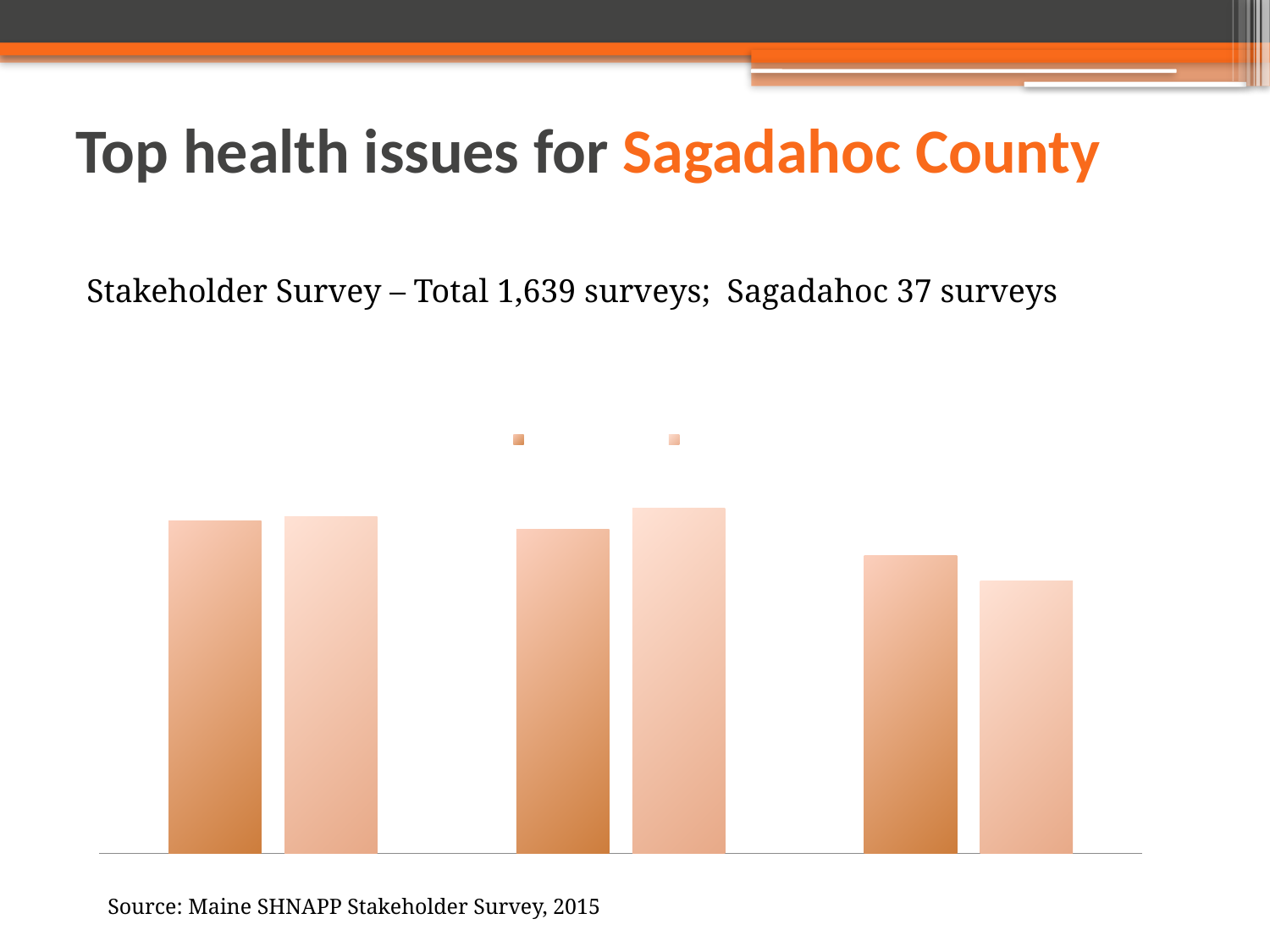
In the middle group of bars, is the darker bar or the lighter bar taller? the lighter bar Which group of bars contains the shortest bar in the chart? the rightmost group In the rightmost group of bars, is the darker bar or the lighter bar taller? the darker bar What is the title of the slide containing the chart? Top health issues for Sagadahoc County What source is cited below the chart? Maine SHNAPP Stakeholder Survey, 2015 How many groups of bars are plotted in the chart? 3 What kind of chart is shown on the slide? bar chart How many series does the chart's legend list? 2 How many bars are plotted in total in the chart? 6